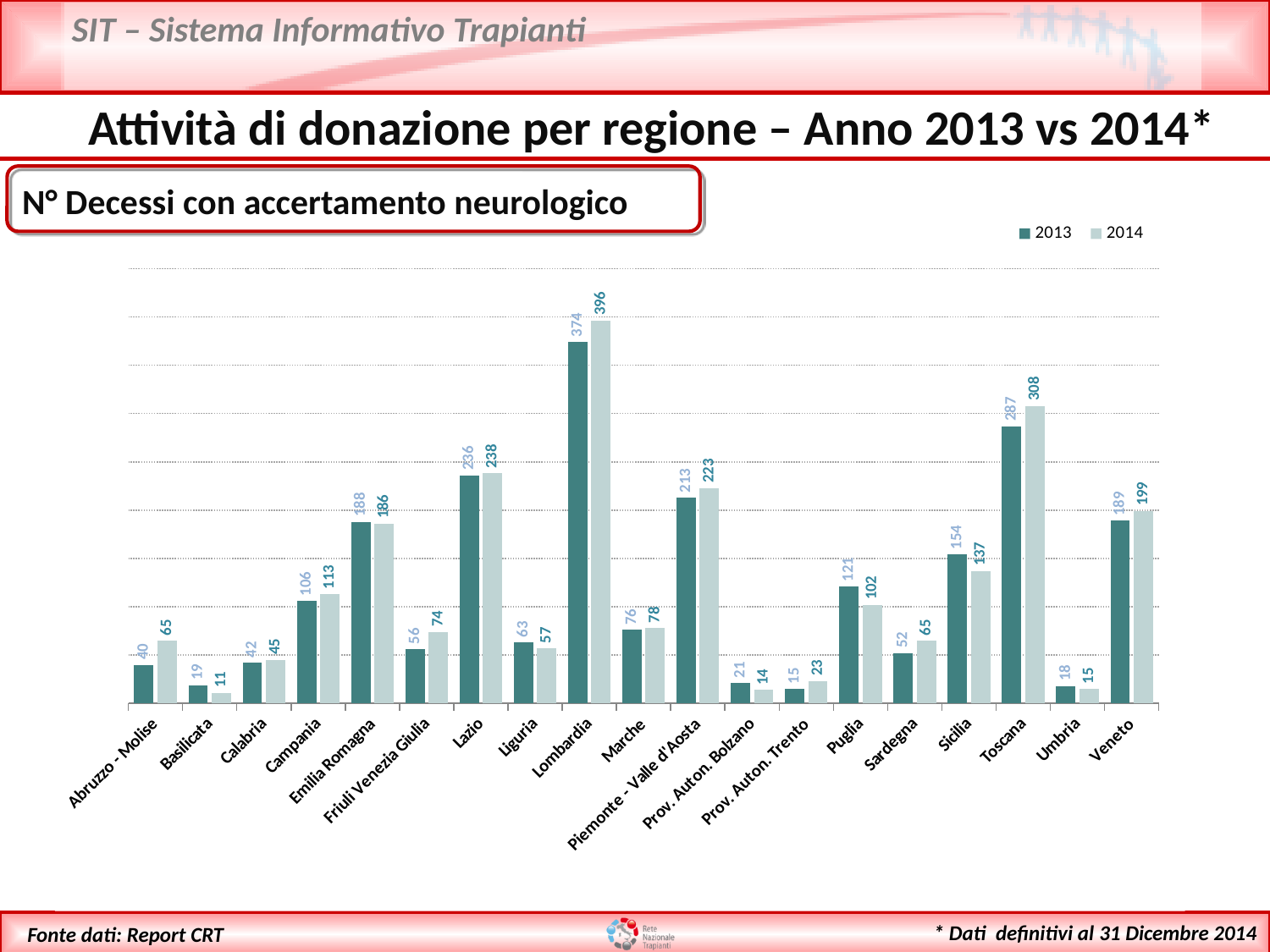
What is the difference between the 2013 and 2014 values for Sicilia? 17 What is the 2014 value for Friuli Venezia Giulia? 74 How many series does the legend list? 2 Which region has the highest 2013 value? Lombardia What is the 2014 value for Lombardia? 396 Which is larger for Piemonte - Valle d'Aosta, the 2013 value or the 2014 value? 2014 What is the 2013 value for Puglia? 121 What is the 2013 value for Toscana? 287 What is the difference between the 2014 and 2013 values for Abruzzo - Molise? 25 How many regions are shown on the x axis? 19 What kind of chart is shown on the slide? Bar chart Which region has the lowest 2014 value? Basilicata